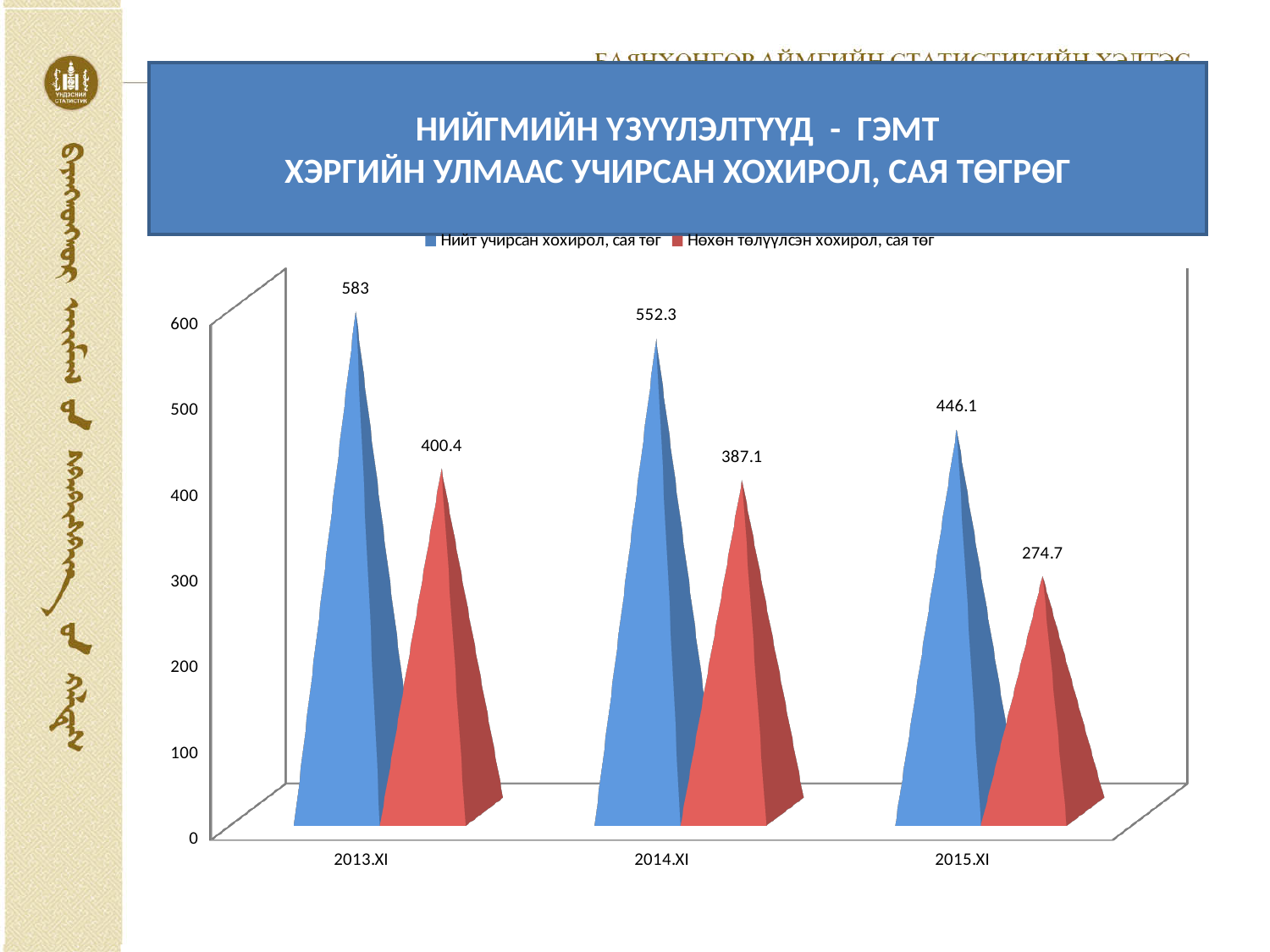
Which is larger: Нийт учирсан хохирол in 2015.XI or Нөхөн төлүүлсэн хохирол in 2013.XI? Нийт учирсан хохирол in 2015.XI In which period is Нийт учирсан хохирол, сая төг the highest? 2013.XI Is the value of Нийт учирсан хохирол, сая төг for 2014.XI greater or less than 500? greater Does Нийт учирсан хохирол, сая төг rise or fall from 2013.XI to 2015.XI? fall How many series does the legend list? 2 What is the value of Нийт учирсан хохирол, сая төг for 2013.XI? 583 In which period is Нөхөн төлүүлсэн хохирол, сая төг the lowest? 2015.XI How many periods are shown on the x axis? 3 What kind of chart is shown on the slide? bar chart What is the value of Нөхөн төлүүлсэн хохирол, сая төг for 2014.XI? 387.1 What is the difference between Нийт учирсан хохирол and Нөхөн төлүүлсэн хохирол in 2014.XI? 165.2 What is the value of Нөхөн төлүүлсэн хохирол, сая төг for 2015.XI? 274.7